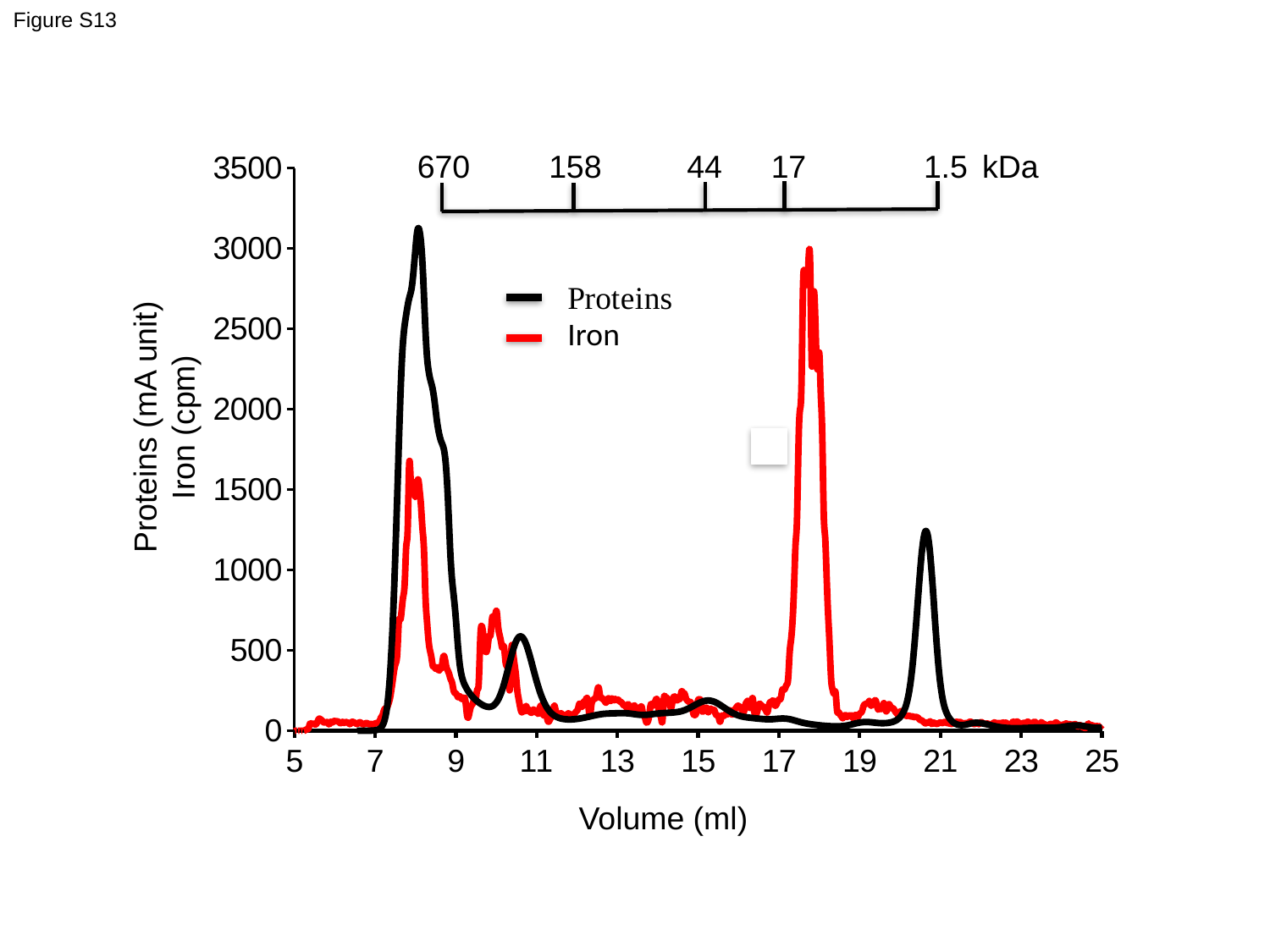
Which colour is used for the Iron series? red Is the highest value of the Proteins series (near 8 ml) greater or less than 2500? greater How many molecular weight markers (kDa) are shown above the chart? 5 Is the Iron peak near 8 ml greater or less than 2000? less At the peak near 8 ml, which series has the larger value, Proteins or Iron? Proteins What kind of chart is shown on the slide? line chart Is the Proteins value at 13 ml greater or less than 500? less How many series does the legend list? 2 At the peak near 18 ml, which series has the larger value, Proteins or Iron? Iron What is the label of the x axis? Volume (ml)